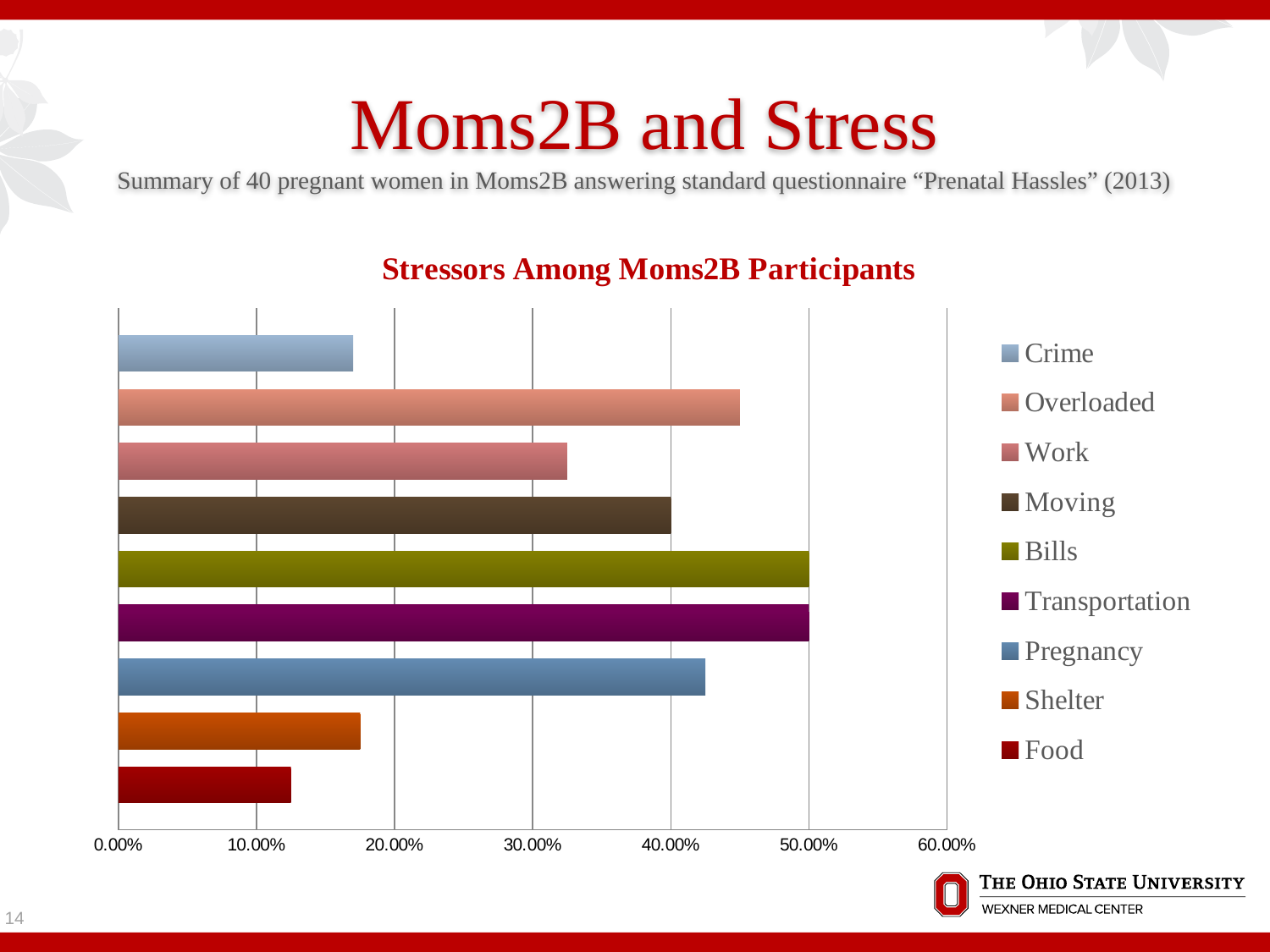
What is the value for Transportation? 50.00% What is the value for Moving? 40.00% Is the value for Overloaded greater or less than 40.00%? greater How many series does the chart's legend list? 9 How many bars are plotted in the chart? 9 Is the value for Food greater or less than 20.00%? less Which is larger, the value for Pregnancy or the value for Crime? Pregnancy What kind of chart is shown on the slide? Bar chart Which stressor has the lowest value in the chart? Food What is the value for Bills? 50.00% Which is larger, the value for Overloaded or the value for Work? Overloaded What is the title of the chart? Stressors Among Moms2B Participants